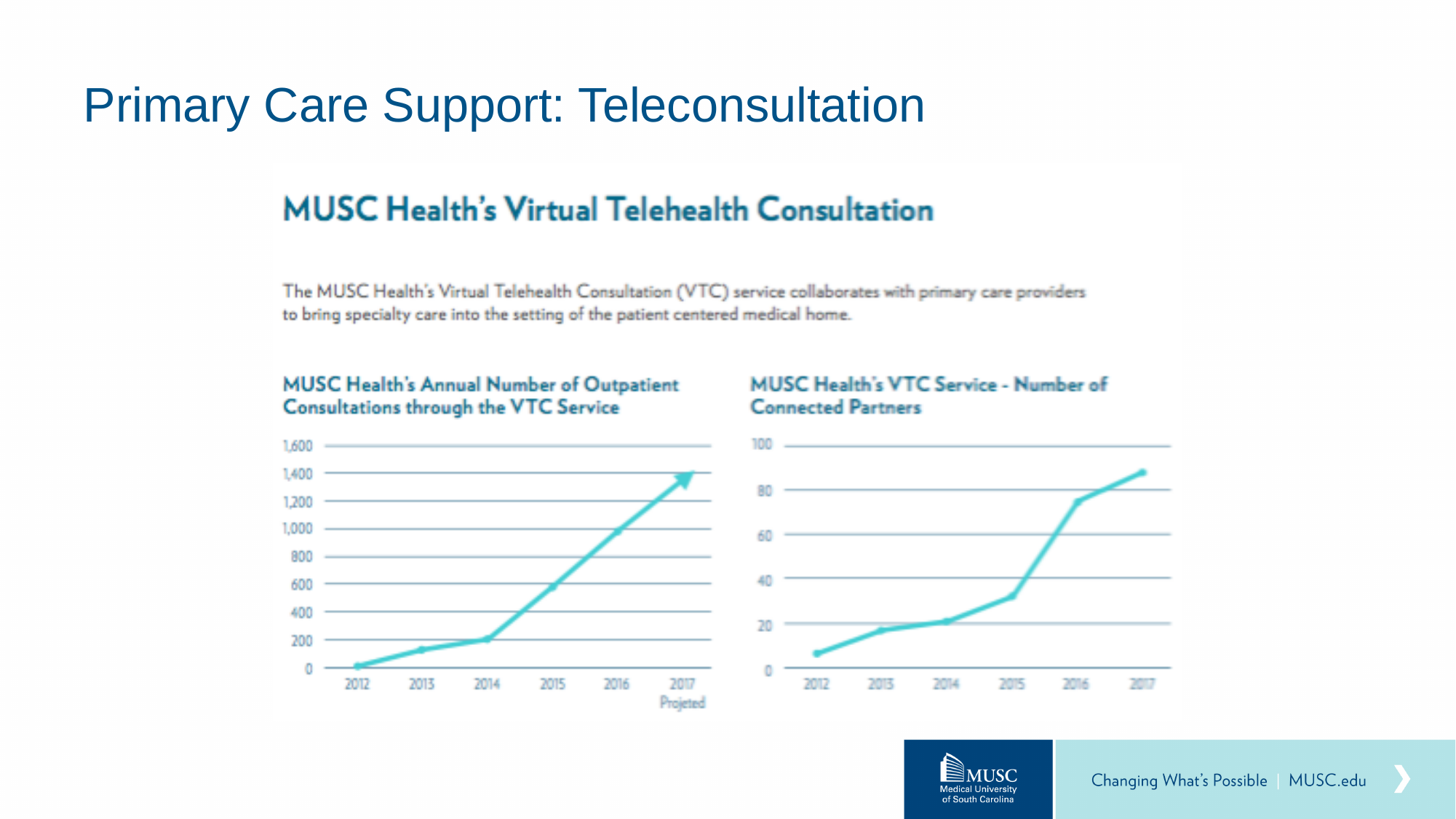
In the 'Number of Connected Partners' chart, how many years are shown on the x axis? 6 In the 'Number of Connected Partners' chart, do the values rise or fall from 2012 to 2017? rise What type of chart is the 'MUSC Health's VTC Service - Number of Connected Partners' chart? line chart In the 'Annual Number of Outpatient Consultations' chart, which year on the x axis is labelled as projected? 2017 In the 'Number of Connected Partners' chart, is the value for 2016 greater or less than 60? greater In the 'Annual Number of Outpatient Consultations' chart, do the values rise or fall from 2012 to 2017? rise In the 'Annual Number of Outpatient Consultations' chart, how many years are shown on the x axis? 6 In the 'Number of Connected Partners' chart, which year has the lowest value? 2012 In the 'Annual Number of Outpatient Consultations' chart, is the value for 2016 greater or less than 800? greater What type of chart is the 'MUSC Health's Annual Number of Outpatient Consultations through the VTC Service' chart? line chart In the 'Annual Number of Outpatient Consultations' chart, which year has the highest value? 2017 In the 'Annual Number of Outpatient Consultations' chart, is the value for 2014 greater or less than 400? less